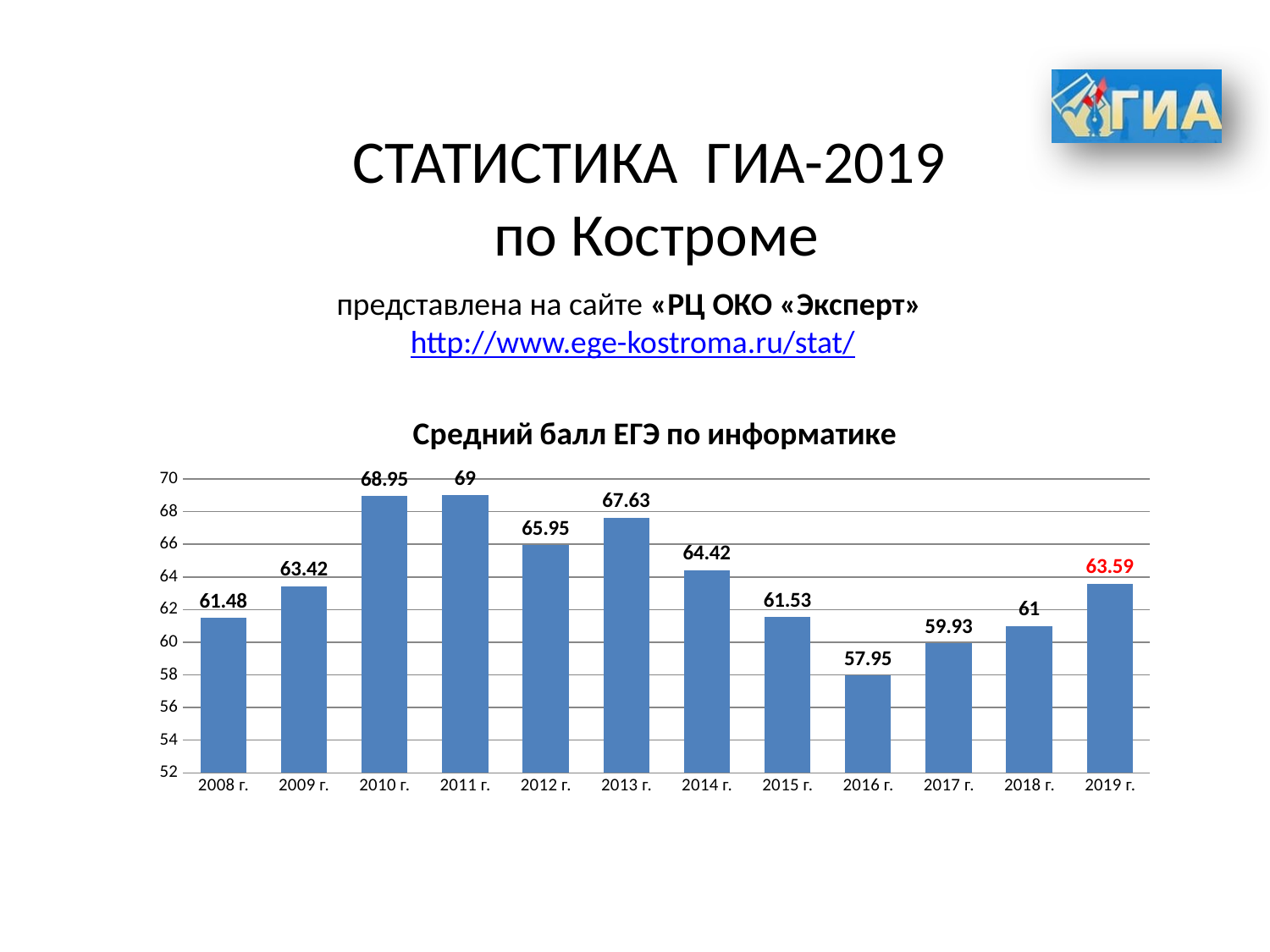
Which year has the lowest average score in the chart? 2016 г. Is the value for 2015 г. greater or less than 62? less Do the values rise or fall from 2011 г. to 2016 г.? fall What value is shown for 2016 г. in the chart 'Средний балл ЕГЭ по информатике'? 57.95 What is the difference between the 2011 г. and 2016 г. values? 11.05 By how much does the 2019 г. value exceed the 2018 г. value? 2.59 Which is larger, the value for 2012 г. or for 2014 г.? 2012 г. Which year has the highest average score in the chart? 2011 г. What is the value for 2013 г.? 67.63 What is the average Informatics EGE score shown for 2019 г.? 63.59 How many years (bars) are shown in the chart? 12 What kind of chart is shown on the slide? bar chart